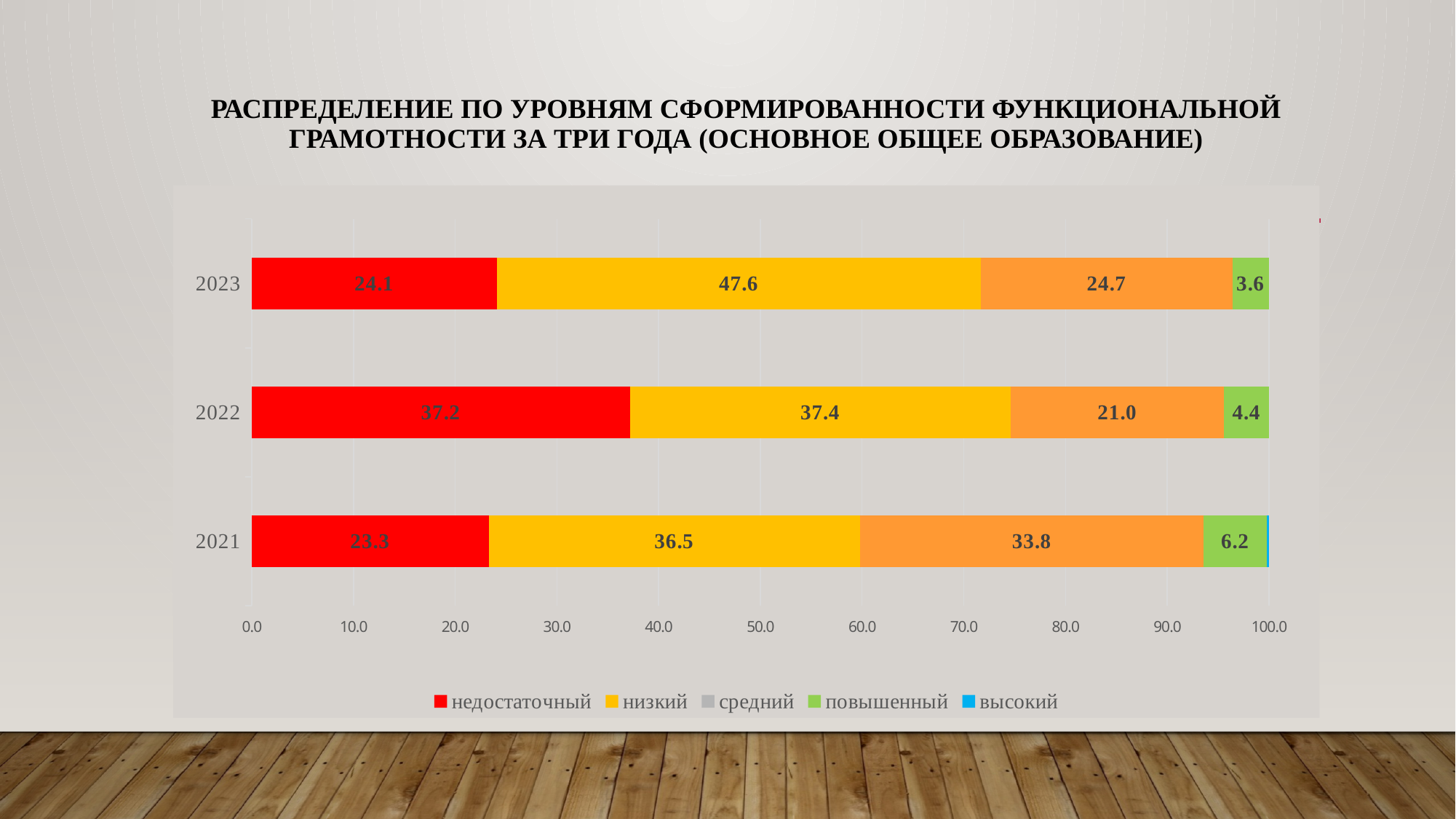
Which year has the highest value for недостаточный? 2022 What colour does the legend use for недостаточный? red What is the value of the недостаточный segment for 2022? 37.2 Which year has the larger недостаточный value, 2021 or 2023? 2023 How many years are shown on the chart? 3 What kind of chart is shown on the slide? stacked bar chart What is the value of the повышенный segment for 2021? 6.2 What is the difference between the низкий values for 2023 and 2022? 10.2 Which year has the lowest value for повышенный? 2023 What is the value of the низкий segment for 2023? 47.6 How many series does the legend list? 5 Is the низкий value for 2023 greater or less than 40.0? greater